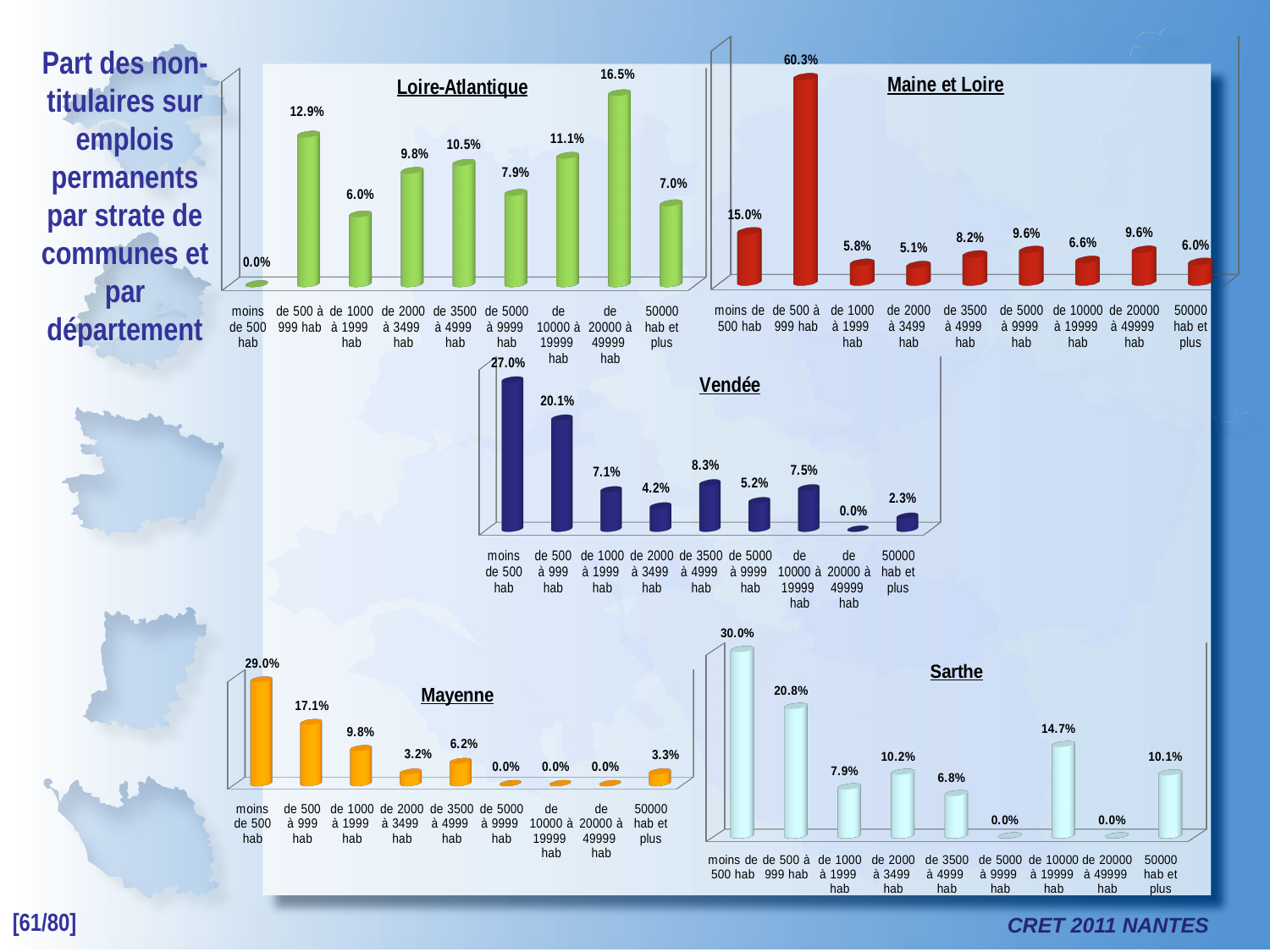
How many department charts are shown on the slide? 5 In the Maine et Loire chart, which category has the highest value? de 500 à 999 hab In the Loire-Atlantique chart, what is the value for communes of 20000 à 49999 hab? 16.5% In the Sarthe chart, what is the value for communes of 10000 à 19999 hab? 14.7% In the Vendée chart, what is the difference between the values for moins de 500 hab and de 500 à 999 hab? 6.9% What type of chart is used for the Vendée data? Bar chart In the Loire-Atlantique chart, which category has the lowest value? moins de 500 hab In the Maine et Loire chart, what is the value for communes of 500 à 999 hab? 60.3% How many categories (strates de communes) are shown in the Mayenne chart? 9 In the Mayenne chart, how many categories have a value of 0.0%? 3 In the Sarthe chart, which is larger: the value for de 2000 à 3499 hab or the value for de 3500 à 4999 hab? de 2000 à 3499 hab In the Vendée chart, what is the value for communes of moins de 500 hab? 27.0%